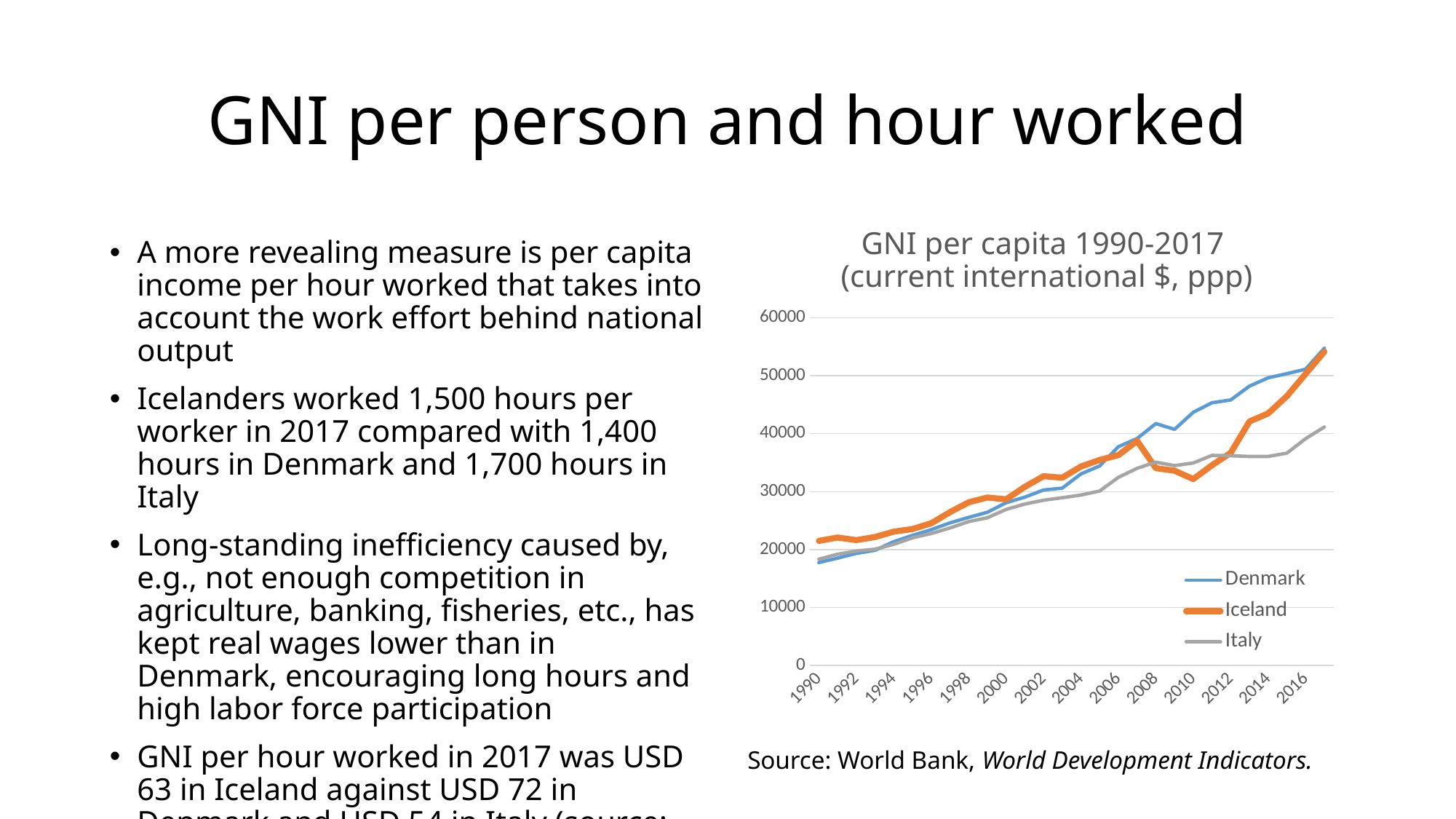
How many series does the legend of the chart list? 3 Is the GNI per capita for Italy in 2000 greater or less than 30000? less Which country has the highest GNI per capita in 2014? Denmark In 2012, which has the larger GNI per capita, Denmark or Iceland? Denmark Does the GNI per capita for Italy generally rise or fall from 1990 to 2017? rise What is the title of the chart? GNI per capita 1990-2017 (current international $, ppp) Is the GNI per capita for Denmark in 2014 greater or less than 40000? greater What kind of chart is shown on the slide? line chart Which country's line is shown in orange in the chart? Iceland Is the GNI per capita for Iceland in 2010 greater or less than 40000? less Which country has the lowest GNI per capita in 2017? Italy Which country has the lowest GNI per capita in 2010? Iceland